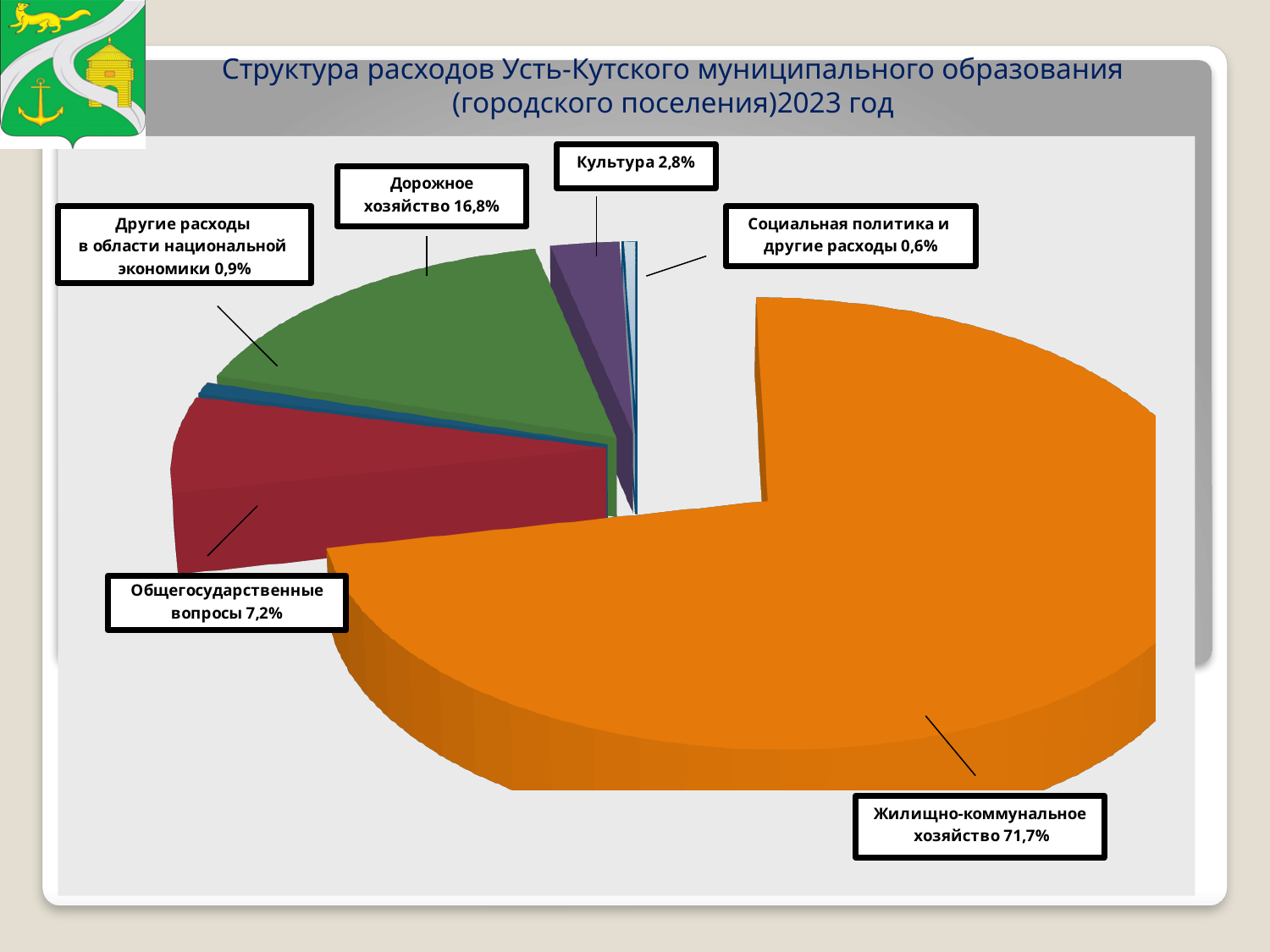
What colour is the slice for Жилищно-коммунальное хозяйство? Orange Which category has the smallest share of the pie? Социальная политика и другие расходы Which category has the largest share of the pie? Жилищно-коммунальное хозяйство Which is larger: the share for Культура or the share for Другие расходы в области национальной экономики? Культура What share of expenditures does Жилищно-коммунальное хозяйство account for? 71,7% How many slices does the pie chart have? 6 What percentage is shown for Дорожное хозяйство? 16,8% What type of chart is shown on the slide? Pie chart What percentage is given for Социальная политика и другие расходы? 0,6% What is the difference in percentage points between Дорожное хозяйство and Общегосударственные вопросы? 9,6 What is the value labelled for Общегосударственные вопросы? 7,2% What share is shown for Культура? 2,8%